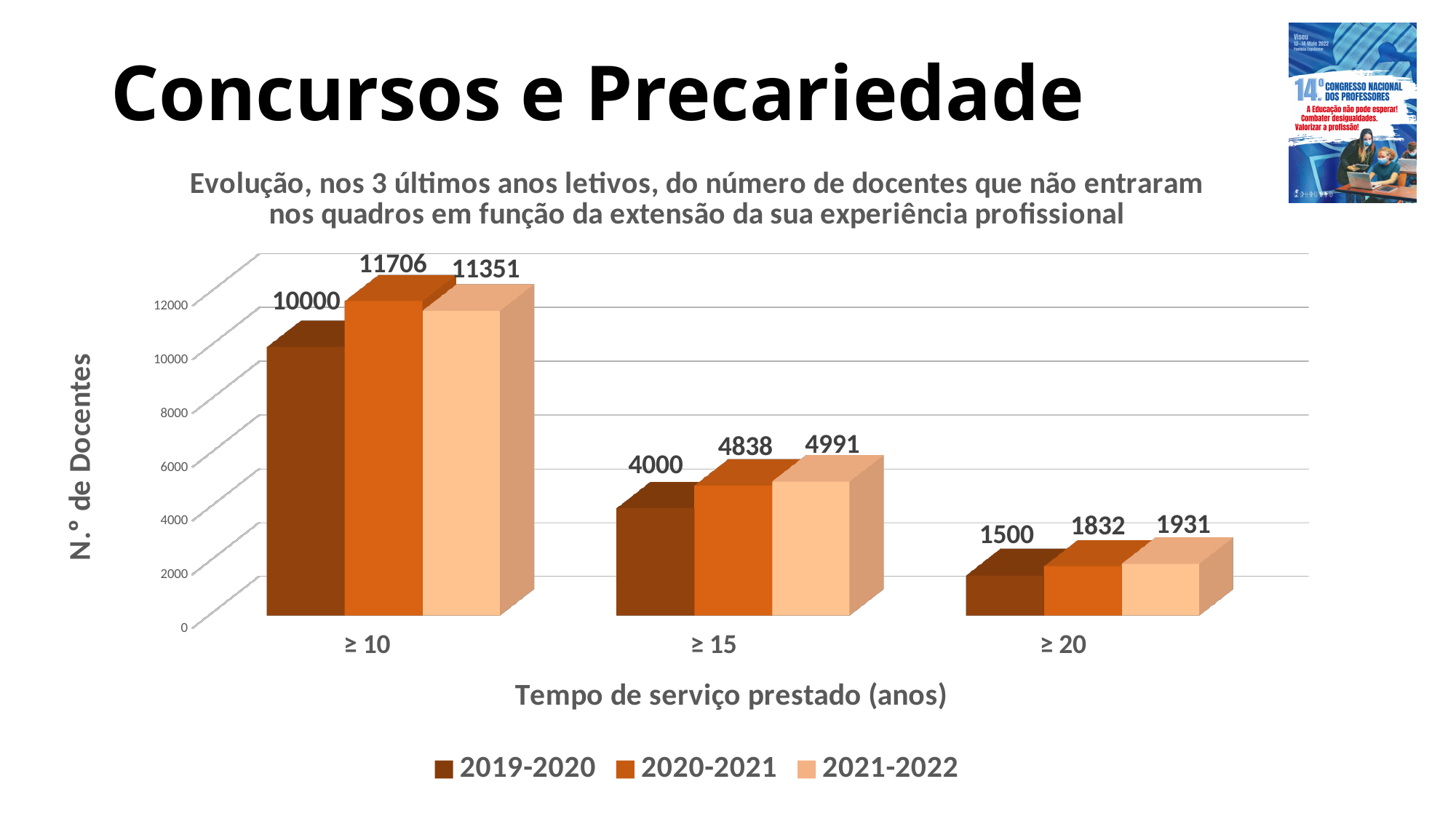
What is the difference between the 2020-2021 and 2019-2020 values in the ≥ 10 category? 1706 Which series has the highest value in the ≥ 10 category? 2020-2021 How many series does the legend list? 3 What kind of chart is shown on the slide? Bar chart Which category has the lowest value for 2019-2020? ≥ 20 What is the value for 2020-2021 in the ≥ 20 category? 1832 What is the value for 2021-2022 in the ≥ 15 category? 4991 Which is larger in the ≥ 15 category: the 2020-2021 value or the 2021-2022 value? 2021-2022 How many categories are shown on the x axis? 3 What is the label of the y axis? N.º de Docentes What is the value for 2019-2020 in the ≥ 10 category? 10000 What is the difference between the 2021-2022 and 2020-2021 values in the ≥ 20 category? 99